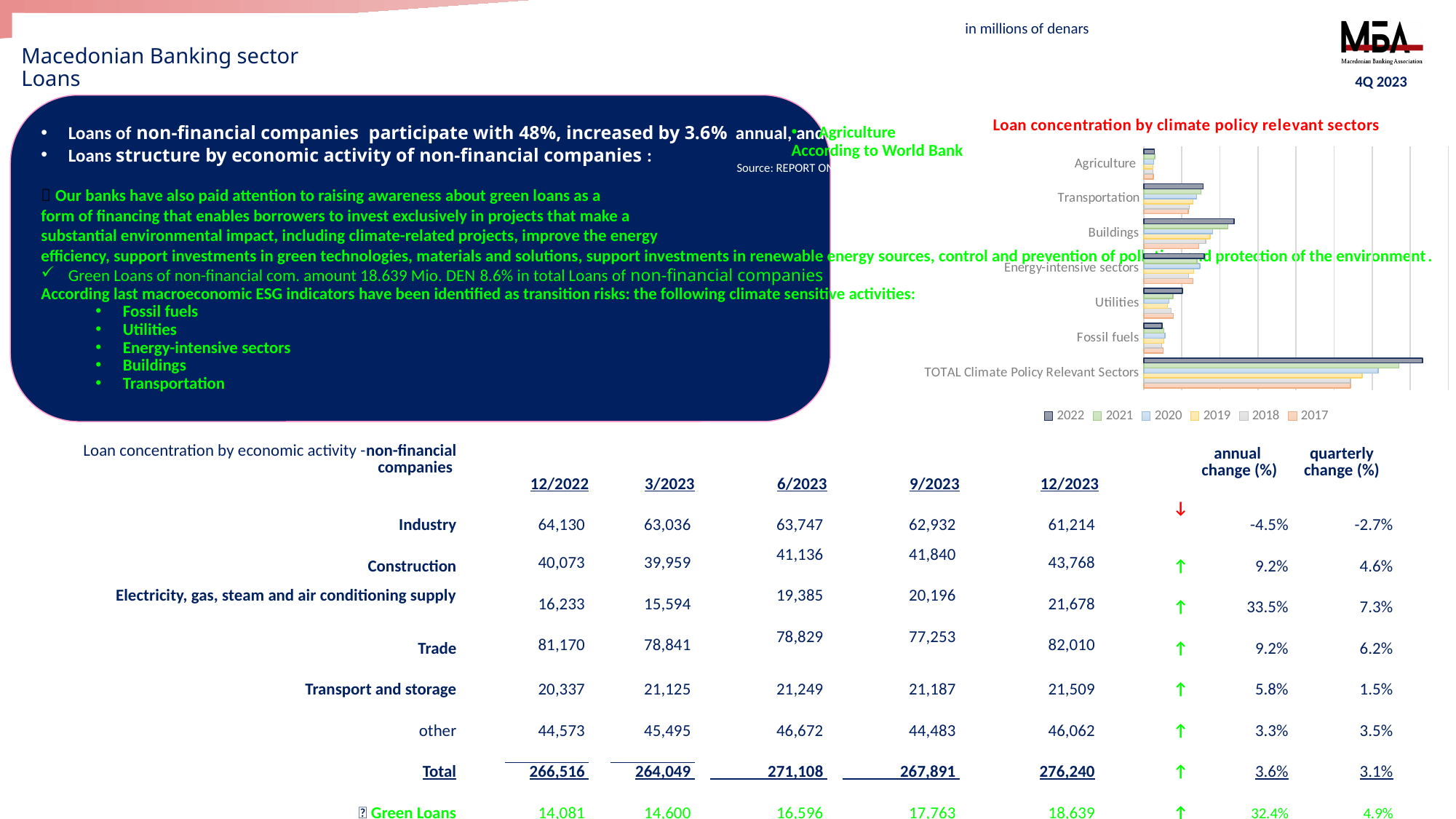
What kind of chart is 'Loan concentration by climate policy relevant sectors'? bar chart How many series does the legend of the 'Loan concentration by climate policy relevant sectors' chart list? 6 Are the bars in the 'Loan concentration by climate policy relevant sectors' chart horizontal or vertical? horizontal In the 'Loan concentration by climate policy relevant sectors' chart, which category has the longest bars overall? TOTAL Climate Policy Relevant Sectors How many categories are shown on the y axis of the 'Loan concentration by climate policy relevant sectors' chart? 7 In the 'Loan concentration by climate policy relevant sectors' chart, is the 2022 bar for Buildings or for Utilities longer? Buildings In the 'Loan concentration by climate policy relevant sectors' chart, is the 2022 bar for Transportation or for Fossil fuels longer? Transportation Which years are listed in the legend of the 'Loan concentration by climate policy relevant sectors' chart? 2022, 2021, 2020, 2019, 2018, 2017 In the 'Loan concentration by climate policy relevant sectors' chart, which category has the shortest bars? Agriculture In the 'Loan concentration by climate policy relevant sectors' chart, excluding the total, which sector has the longest 2022 bar? Buildings In the 'Loan concentration by climate policy relevant sectors' chart, is the 2022 bar for Agriculture or for Energy-intensive sectors longer? Energy-intensive sectors